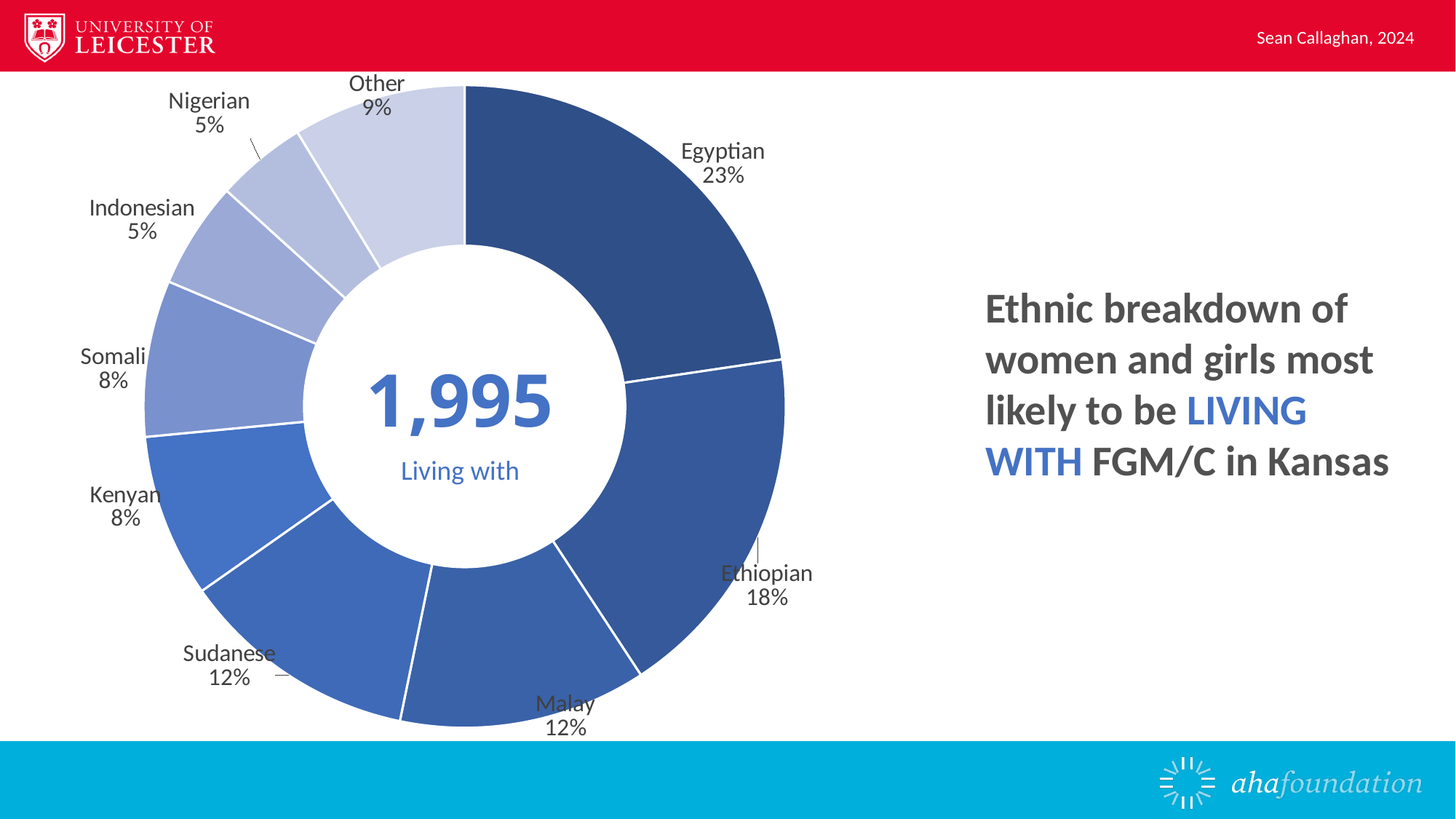
What is the difference in percentage points between the Egyptian and Ethiopian slices? 5 percentage points What percentage is shown for the Somali slice? 8% Which slice is larger, Kenyan or Malay? Malay What share of the chart does the Egyptian slice represent? 23% What percentage is shown for the Other slice? 9% What kind of chart is shown on the slide? Doughnut (pie) chart How many slices (categories) does the chart have? 9 What percentage is shown for the Ethiopian slice? 18% Which ethnic group has the largest share in the chart? Egyptian Which two ethnic groups have the smallest share in the chart? Indonesian and Nigerian What number is printed in the centre of the doughnut chart? 1,995 What is the difference in percentage points between the Other slice and the Nigerian slice? 4 percentage points